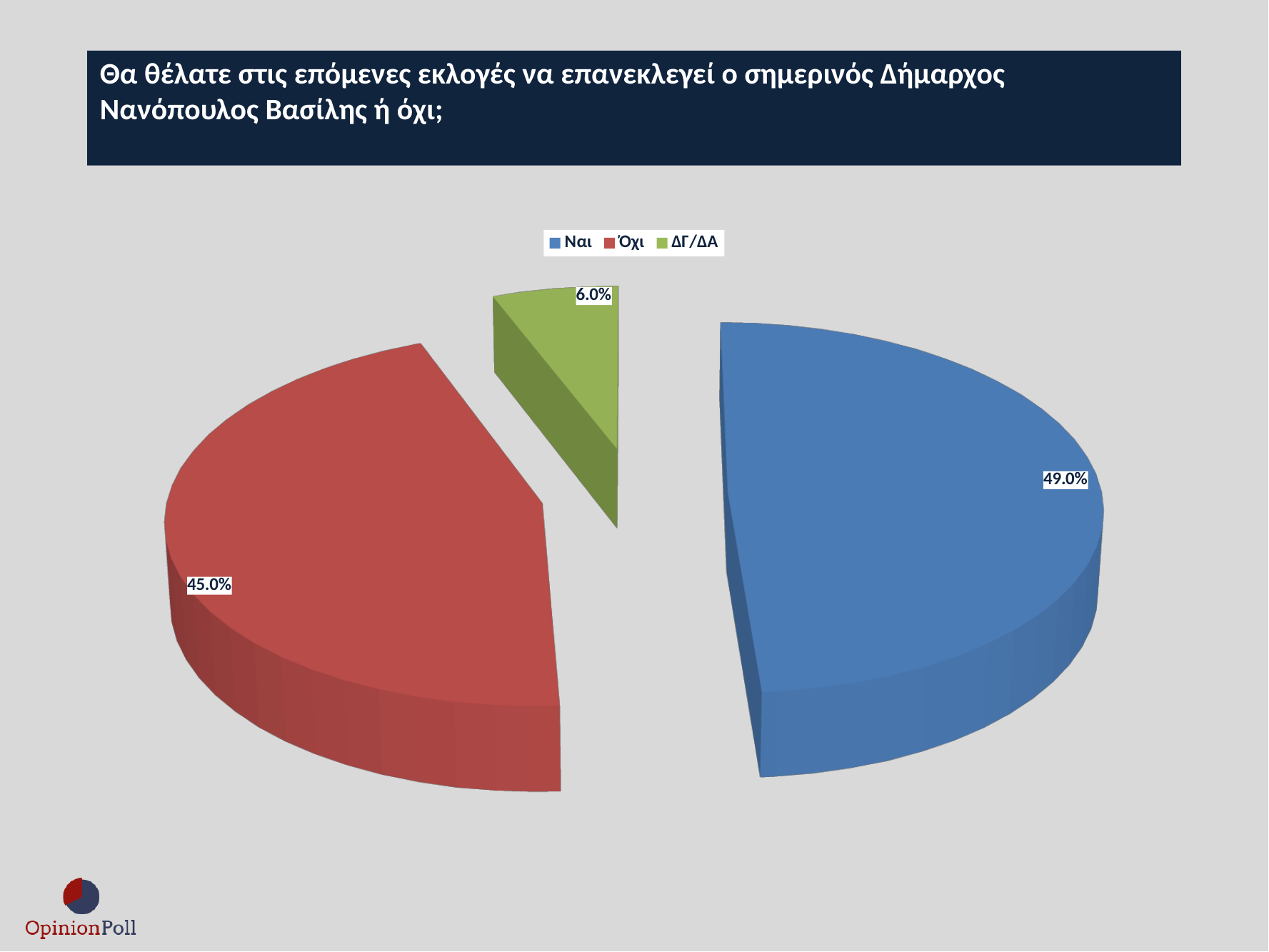
Which response has the largest share of the pie? Ναι What kind of chart is shown on the slide? Pie chart What percentage of respondents answered Ναι? 49.0% What percentage of respondents answered ΔΓ/ΔΑ? 6.0% What percentage of respondents answered Όχι? 45.0% Which is larger, the share for Όχι or the share for ΔΓ/ΔΑ? Όχι What is the difference in percentage points between Ναι and Όχι? 4.0 How many entries does the legend list? 3 What colour is the slice for Όχι? Red How many slices does the pie chart have? 3 Which response has the smallest share of the pie? ΔΓ/ΔΑ What is the difference in percentage points between Όχι and ΔΓ/ΔΑ? 39.0